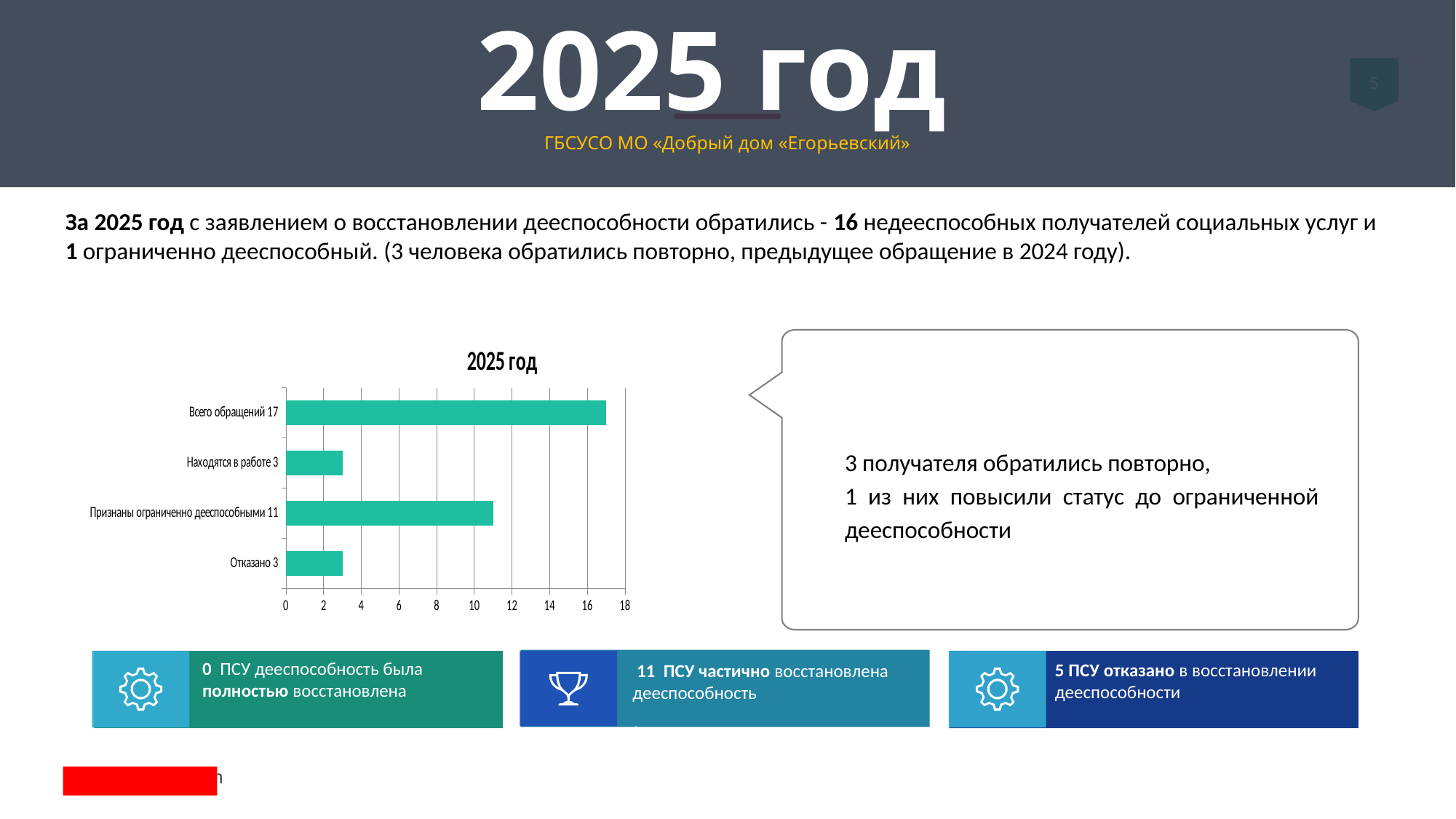
What is the maximum value shown on the horizontal axis? 18 What is the value for "Всего обращений"? 17 What is the value for "Признаны ограниченно дееспособными"? 11 What type of chart is shown on the slide? bar chart What is the title of the chart? 2025 год Which is larger: "Признаны ограниченно дееспособными" or "Находятся в работе"? Признаны ограниченно дееспособными Is the value for "Признаны ограниченно дееспособными" greater or less than 10? greater Which category has the highest value? Всего обращений What is the value for "Находятся в работе"? 3 How many categories (bars) does the chart show? 4 What is the difference between "Всего обращений" and "Признаны ограниченно дееспособными"? 6 What is the value for "Отказано"? 3